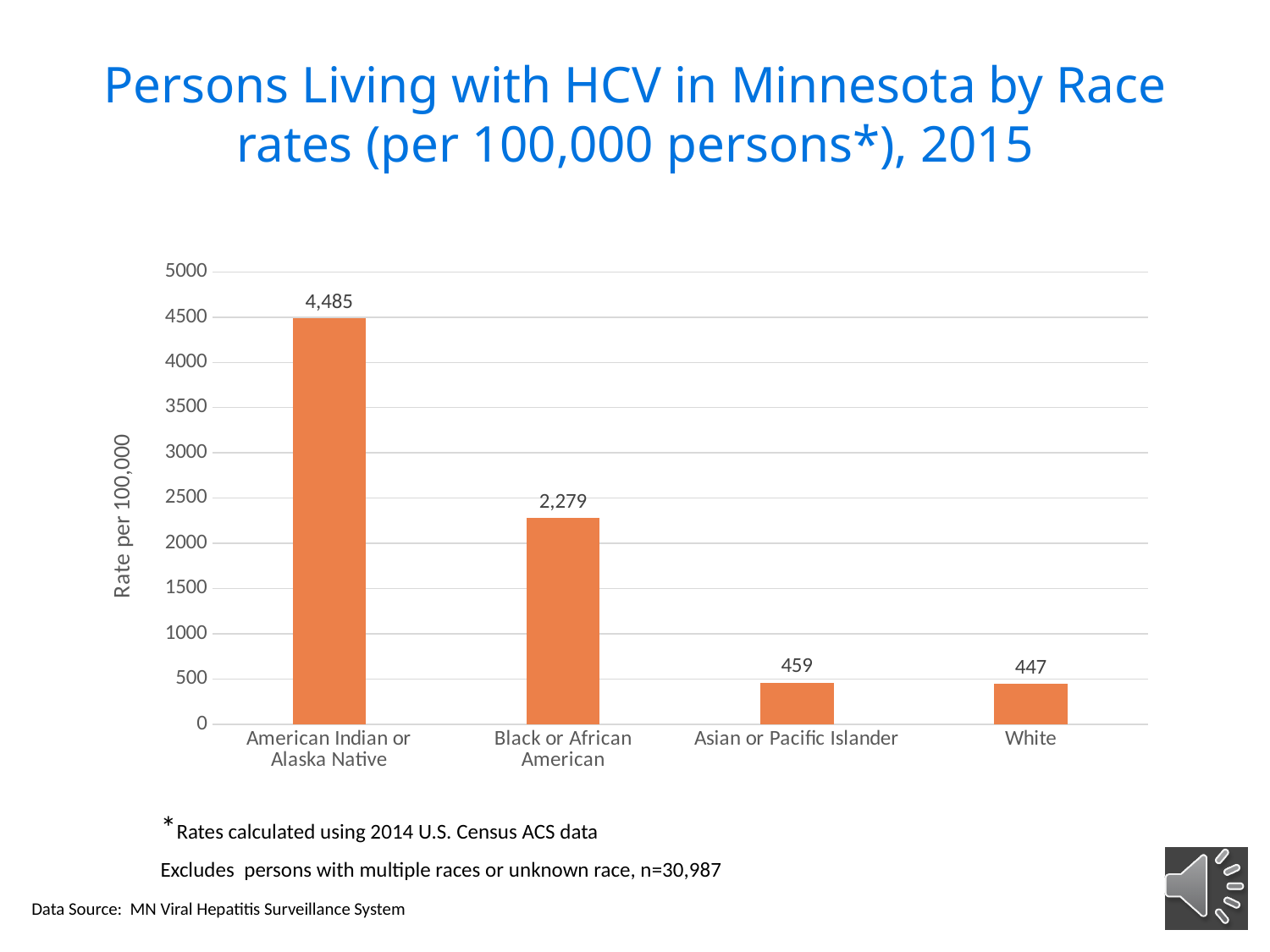
What is the rate per 100,000 for Asian or Pacific Islander? 459 What is the rate per 100,000 for White? 447 What is the rate per 100,000 for American Indian or Alaska Native? 4,485 What is the label of the vertical axis? Rate per 100,000 What is the rate per 100,000 for Black or African American? 2,279 What is the difference between the rates for Asian or Pacific Islander and White? 12 What kind of chart is shown on the slide? Bar chart What is the difference between the rates for American Indian or Alaska Native and Black or African American? 2,206 Which race category has the highest rate? American Indian or Alaska Native Which has a larger rate, Black or African American or Asian or Pacific Islander? Black or African American How many race categories are shown on the chart? 4 Which race category has the lowest rate? White